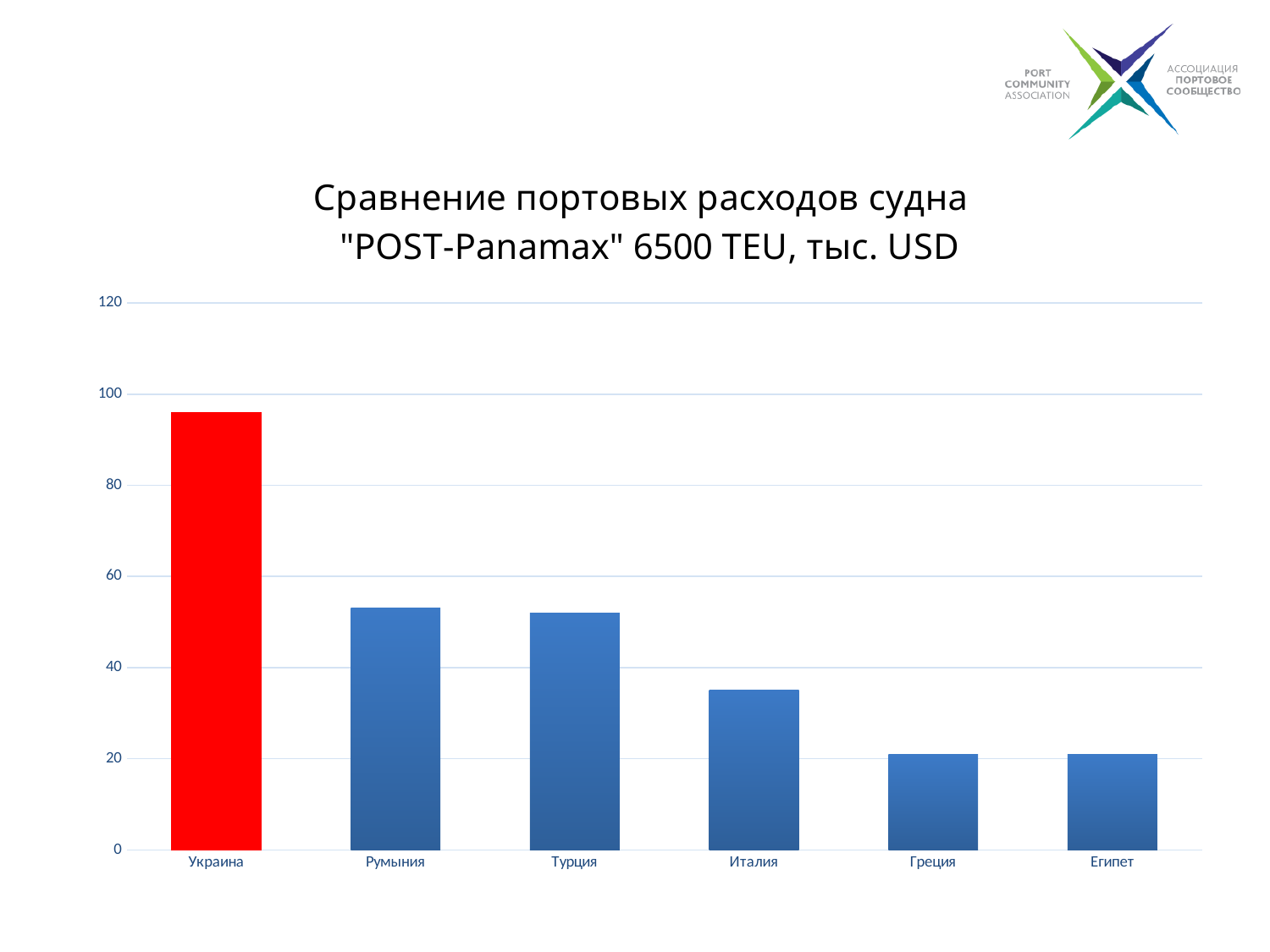
Is the value for Греция greater or less than 40? less Is the value for Румыния greater or less than 40? greater Which is larger, the value for Украина or the value for Италия? Украина Which country has the highest port costs in the chart? Украина Is the value for Украина greater or less than 80? greater How many countries are shown on the x axis of the chart? 6 Do the values generally rise or fall from left to right along the x axis? fall What colour is the bar for Украина? red What kind of chart is shown on the slide? bar chart